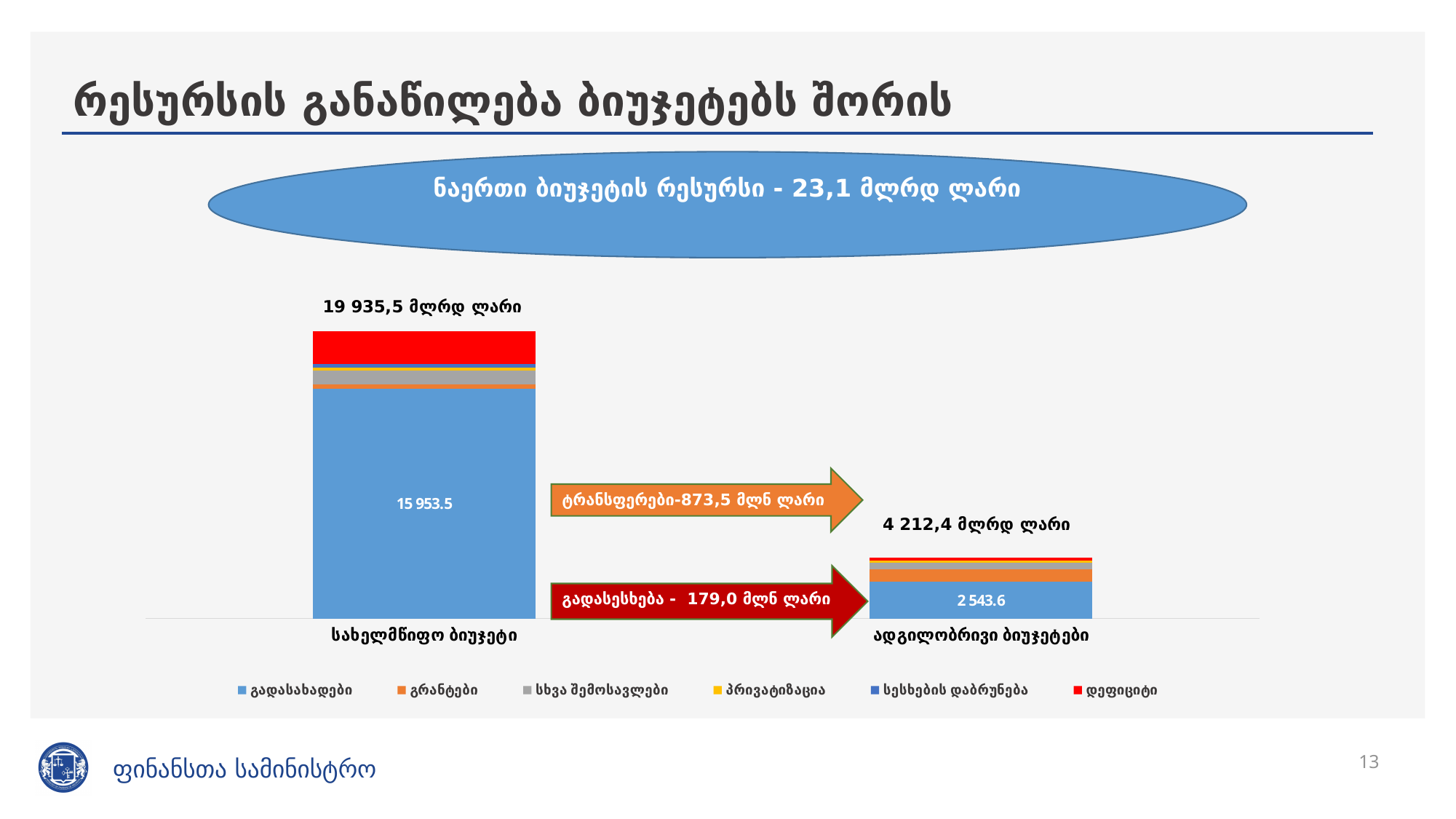
How many series does the chart legend list? 6 What is the value of გადასახადები for ადგილობრივი ბიუჯეტები? 2 543.6 Which legend entry is shown in red? დეფიციტი Which legend entry is shown in orange? გრანტები What is the difference between the labelled totals of the two bars? 15 723,1 What total is labelled above the სახელმწიფო ბიუჯეტი bar? 19 935,5 მლრდ ლარი What total is labelled above the ადგილობრივი ბიუჯეტები bar? 4 212,4 მლრდ ლარი How many categories are shown on the x axis of the chart? 2 What kind of chart is shown on the slide? Stacked bar chart What is the value of გადასახადები for სახელმწიფო ბიუჯეტი? 15 953.5 What is the difference between the გადასახადები values for სახელმწიფო ბიუჯეტი and ადგილობრივი ბიუჯეტები? 13 409.9 Which category has the higher total, სახელმწიფო ბიუჯეტი or ადგილობრივი ბიუჯეტები? სახელმწიფო ბიუჯეტი